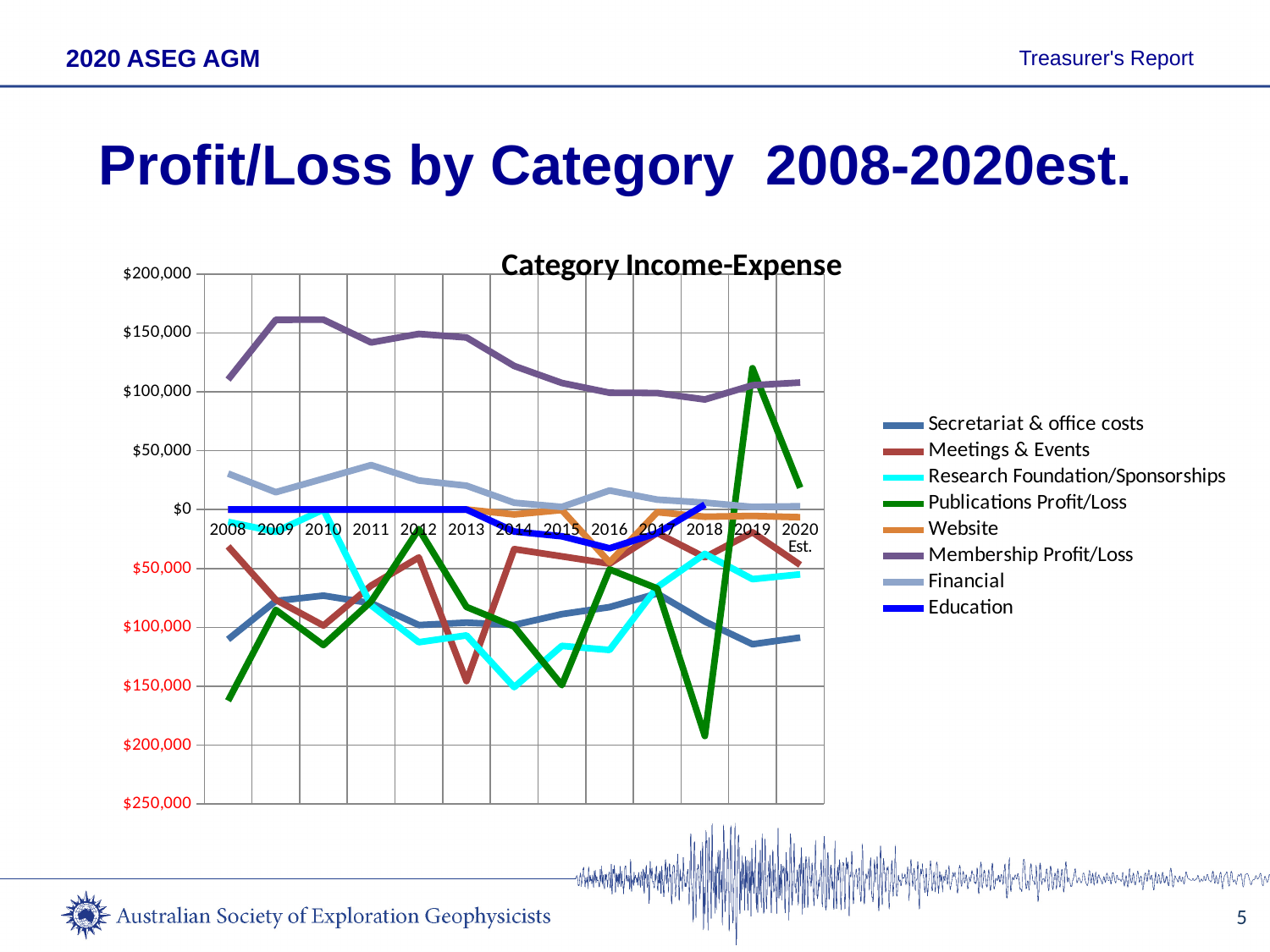
In which year is Publications Profit/Loss at its highest? 2019 Which series is highest in 2009? Membership Profit/Loss In which year is Publications Profit/Loss at its lowest? 2018 Which is larger, Membership Profit/Loss in 2008 or in 2009? 2009 How many series does the legend of the chart list? 8 Which series is lowest in 2018? Publications Profit/Loss How many years (x-axis points) are plotted on the chart? 13 Does Membership Profit/Loss generally rise or fall from 2010 to 2018? fall What is the title of the chart? Category Income-Expense What kind of chart is shown on the slide? line chart Is the value for Membership Profit/Loss in 2009 greater or less than $150,000? greater Is the value for Publications Profit/Loss in 2019 greater or less than $100,000? greater